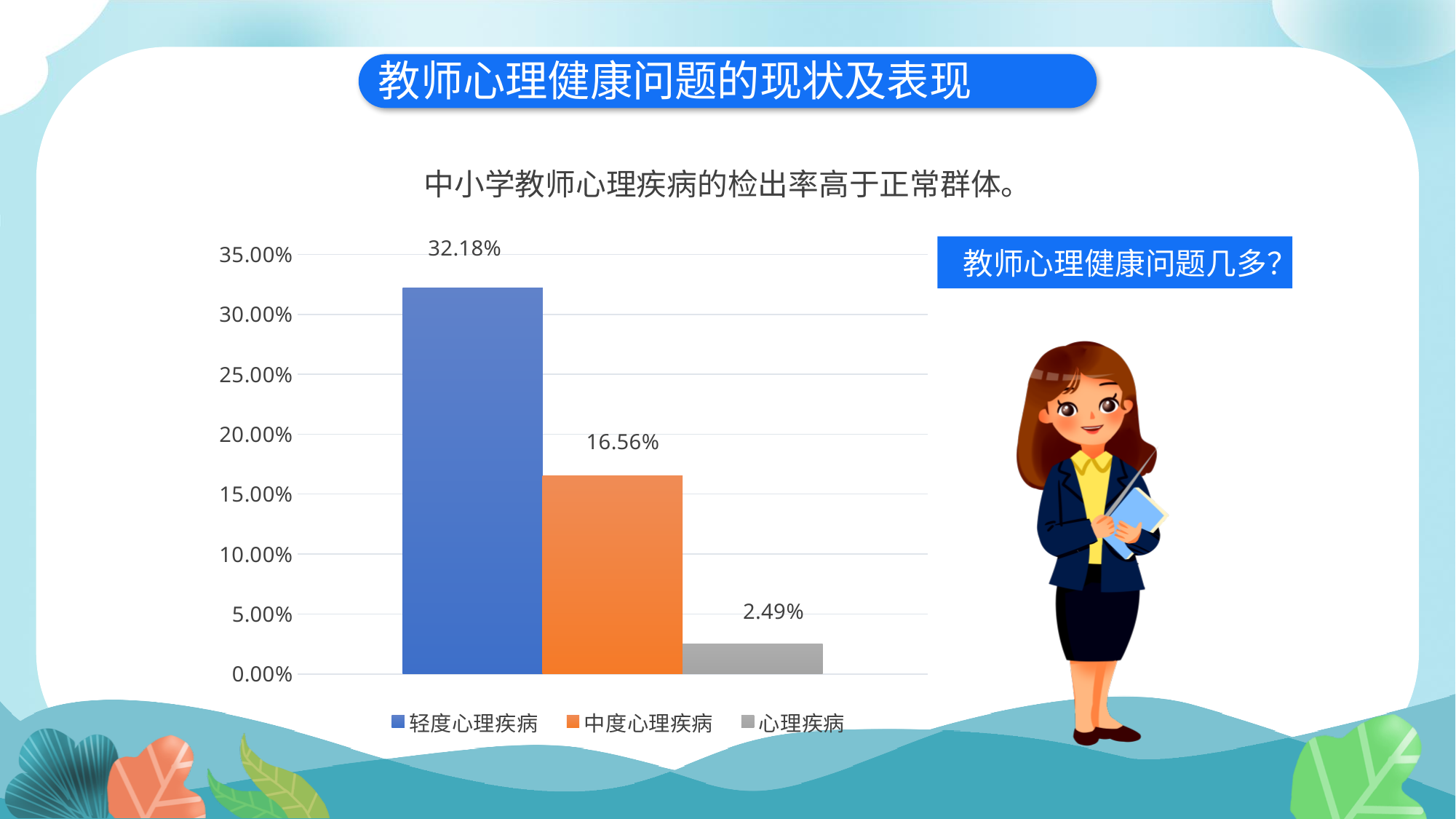
Which series has the lowest value? 心理疾病 What colour is the bar for 中度心理疾病? orange What is the value for 轻度心理疾病? 32.18% How many series does the legend list? 3 What kind of chart is shown on the slide? bar chart What is the difference between the values for 轻度心理疾病 and 中度心理疾病? 15.62% What is the difference between the values for 中度心理疾病 and 心理疾病? 14.07% What is the value for 心理疾病? 2.49% What is the value for 中度心理疾病? 16.56% Is the value for 轻度心理疾病 greater or less than 30.00%? greater Which is larger, the value for 中度心理疾病 or the value for 心理疾病? 中度心理疾病 Which series has the highest value? 轻度心理疾病